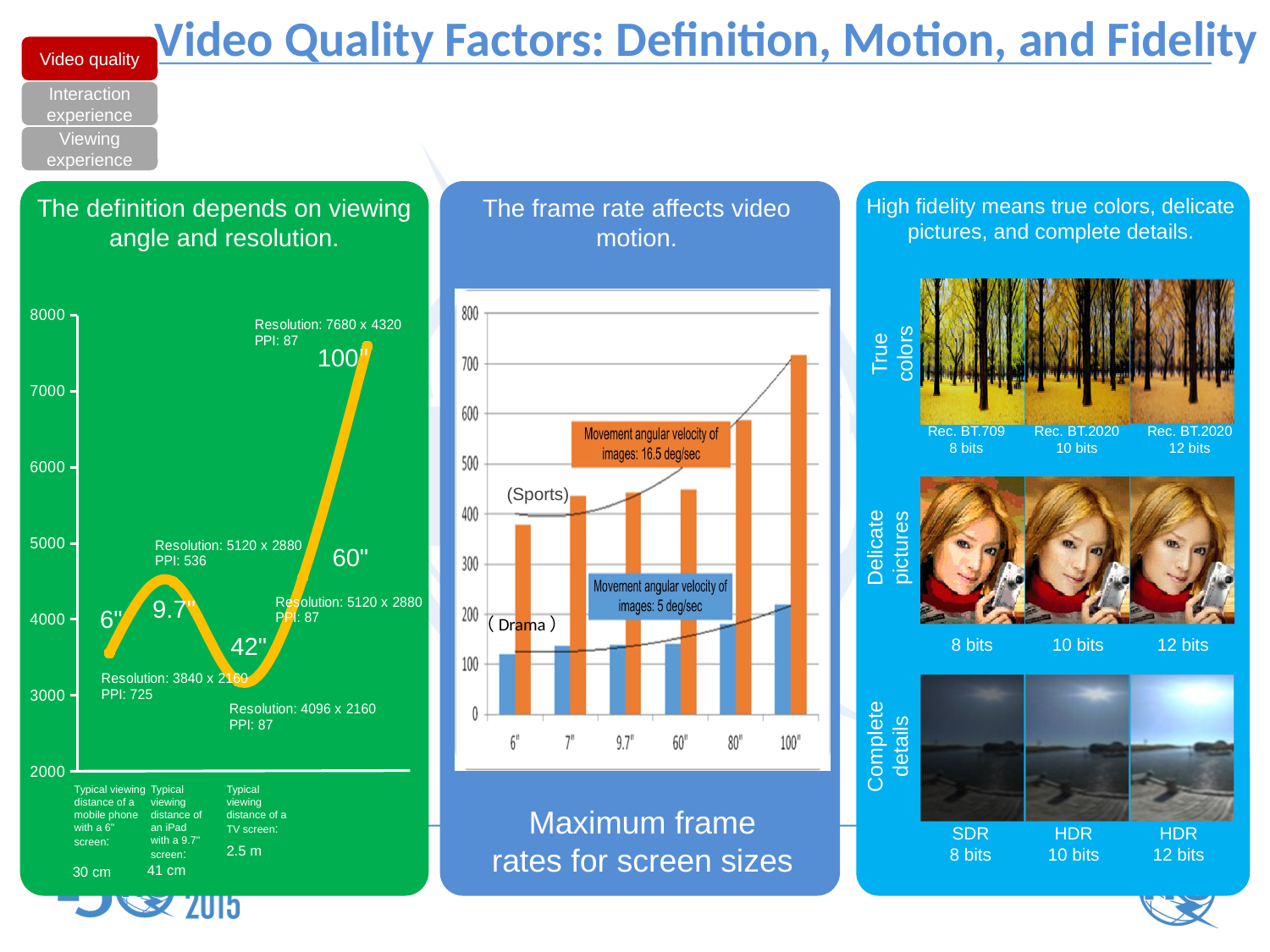
What kind of chart is shown in the left green panel about definition, viewing angle and resolution? line chart In the middle bar chart, is the orange bar (16.5 deg/sec) for 80" greater or less than 500? greater In the left line chart, which screen size has the highest point? 100" In the middle bar chart, is the orange bar (16.5 deg/sec) for 6" greater or less than 400? less In the middle bar chart, is the blue bar (5 deg/sec) for 100" greater or less than 200? greater In the middle bar chart, do the orange bars (16.5 deg/sec) generally rise or fall as screen size increases from 6" to 100"? rise In the middle bar chart, which screen size has the highest orange bar (16.5 deg/sec)? 100" In the middle bar chart, how many series (movement angular velocities) are plotted? 2 What kind of chart is shown in the middle panel under 'The frame rate affects video motion'? bar chart In the left line chart, how many screen sizes are marked along the line? 5 In the middle bar chart, how many screen sizes are shown on the x axis? 6